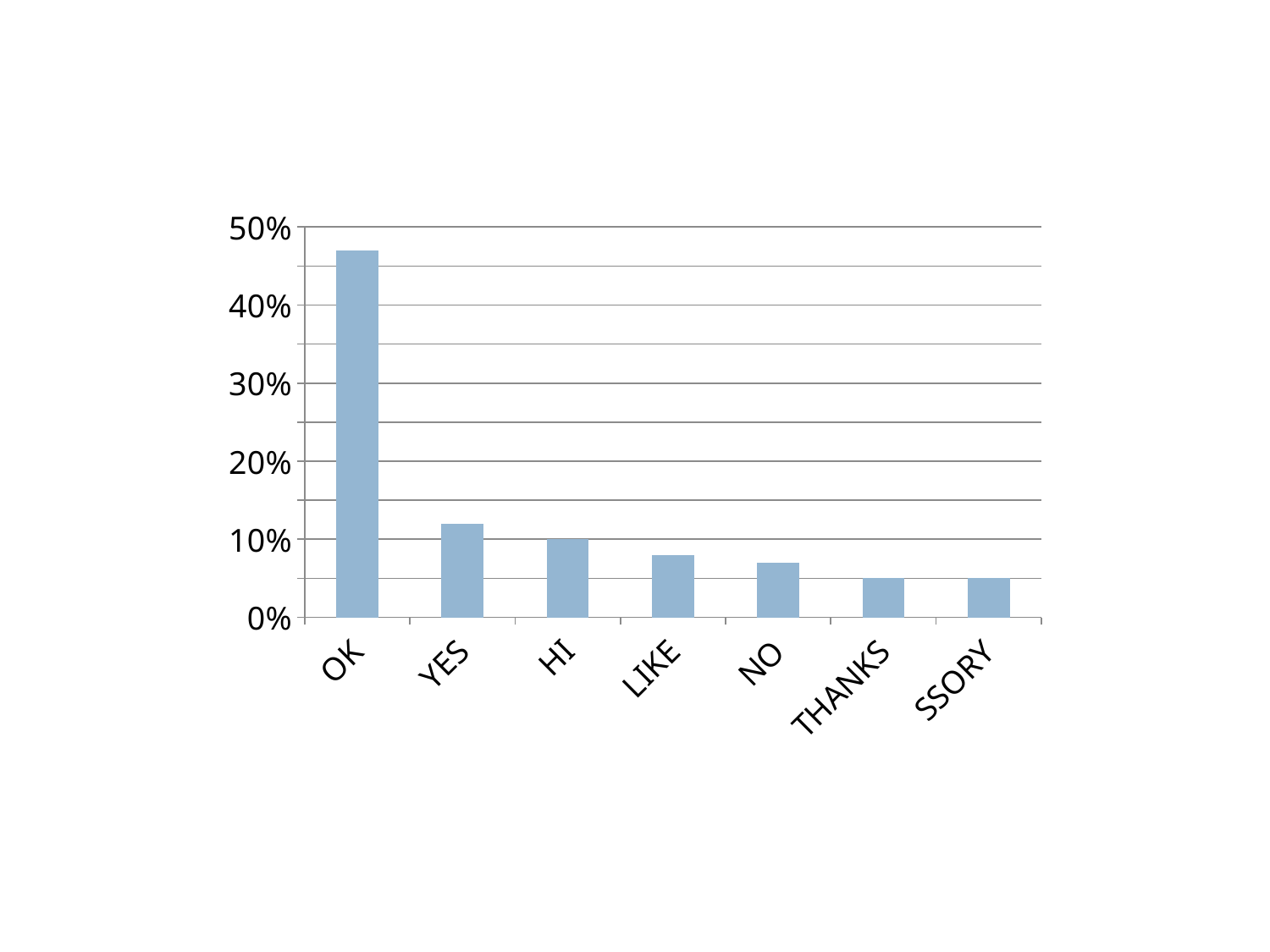
Is the value for LIKE greater or less than 10%? less Is the value for THANKS greater or less than 10%? less Is the value for YES greater or less than 10%? greater What kind of chart is shown on the slide? bar chart Do the values rise or fall from left to right along the x axis? fall What is the label of the last category on the x axis? SSORY Which category has the highest value? OK Which is larger, the value for OK or the value for YES? OK Which is larger, the value for YES or the value for HI? YES How many categories are shown on the x axis? 7